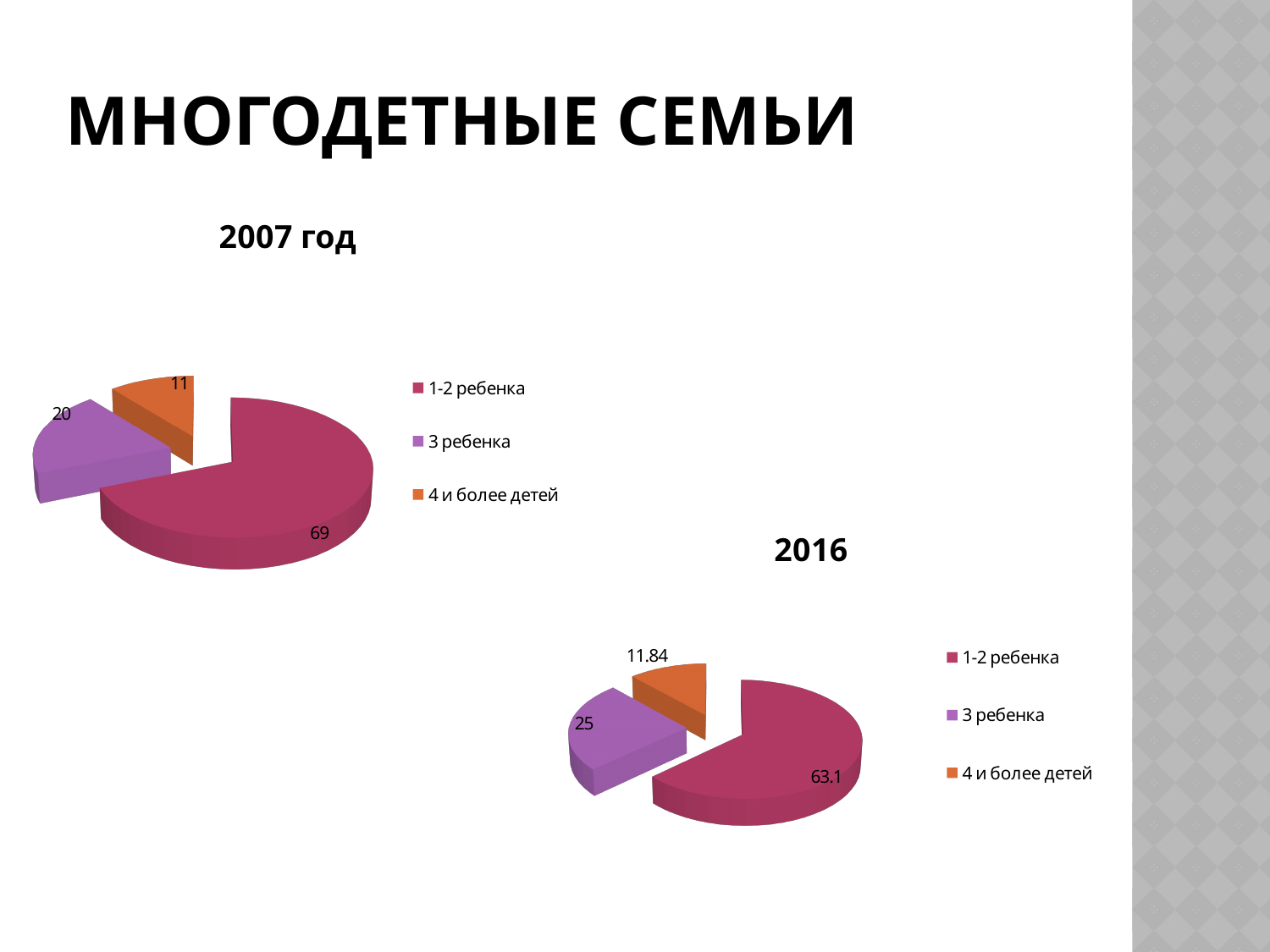
In the 2016 chart, what is the value for 4 и более детей? 11.84 In the 2007 год chart, what is the value for 4 и более детей? 11 Which is larger: the value for 3 ребенка in the 2007 год chart or in the 2016 chart? 2016 How many slices does the 2016 chart have? 3 In the 2007 год chart, what is the value for 1-2 ребенка? 69 In the 2007 год chart, which category has the smallest slice? 4 и более детей In the 2016 chart, what is the difference between the values for 3 ребенка and 4 и более детей? 13.16 In the 2016 chart, which category has the largest slice? 1-2 ребенка In the 2007 год chart, what is the value for 3 ребенка? 20 In the 2016 chart, what is the value for 1-2 ребенка? 63.1 What type of chart is the 2007 год chart? Pie chart In the 2007 год chart, what is the difference between the values for 1-2 ребенка and 3 ребенка? 49